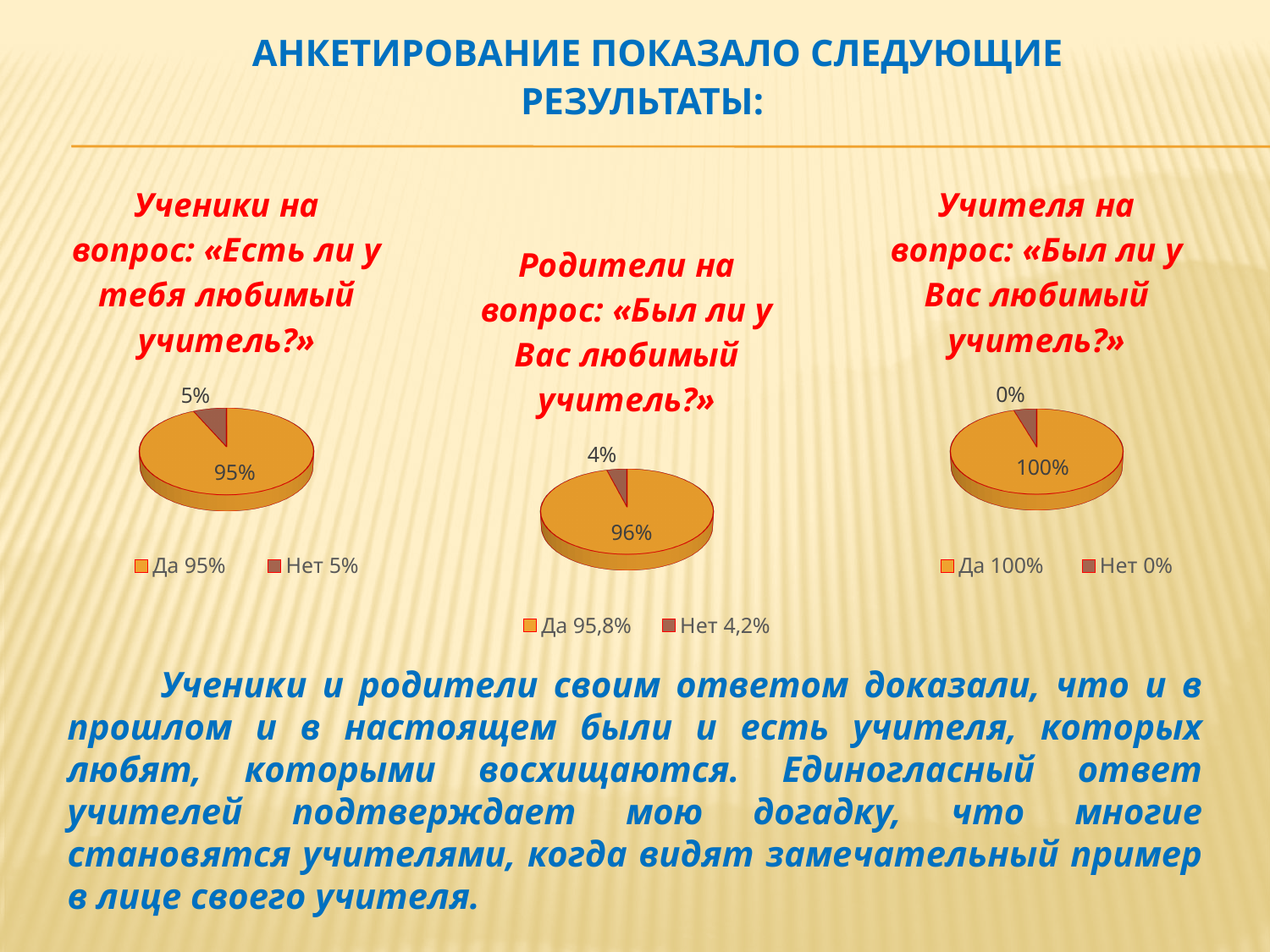
What kind of chart is used on the left chart about students (Ученики)? pie chart On the right chart (Учителя), what percentage is shown for the 'Да' slice? 100% On the left chart (Ученики), what is the difference between the 'Да' and 'Нет' percentages? 90% On the left chart (Ученики), what percentage is shown for the 'Нет' slice? 5% On the middle chart (Родители), what value does the legend give for 'Нет'? 4,2% On the middle chart (Родители), what data label is shown on the larger slice? 96% On the middle chart (Родители), what data label is shown on the smaller slice? 4% On the right chart (Учителя), what percentage is shown for the 'Нет' slice? 0% How many entries does the legend of the right chart (Учителя) list? 2 On the left chart (Ученики), what percentage is shown for the 'Да' slice? 95% On the left chart (Ученики), which slice is the largest? Да How many pie charts are shown on the slide? 3